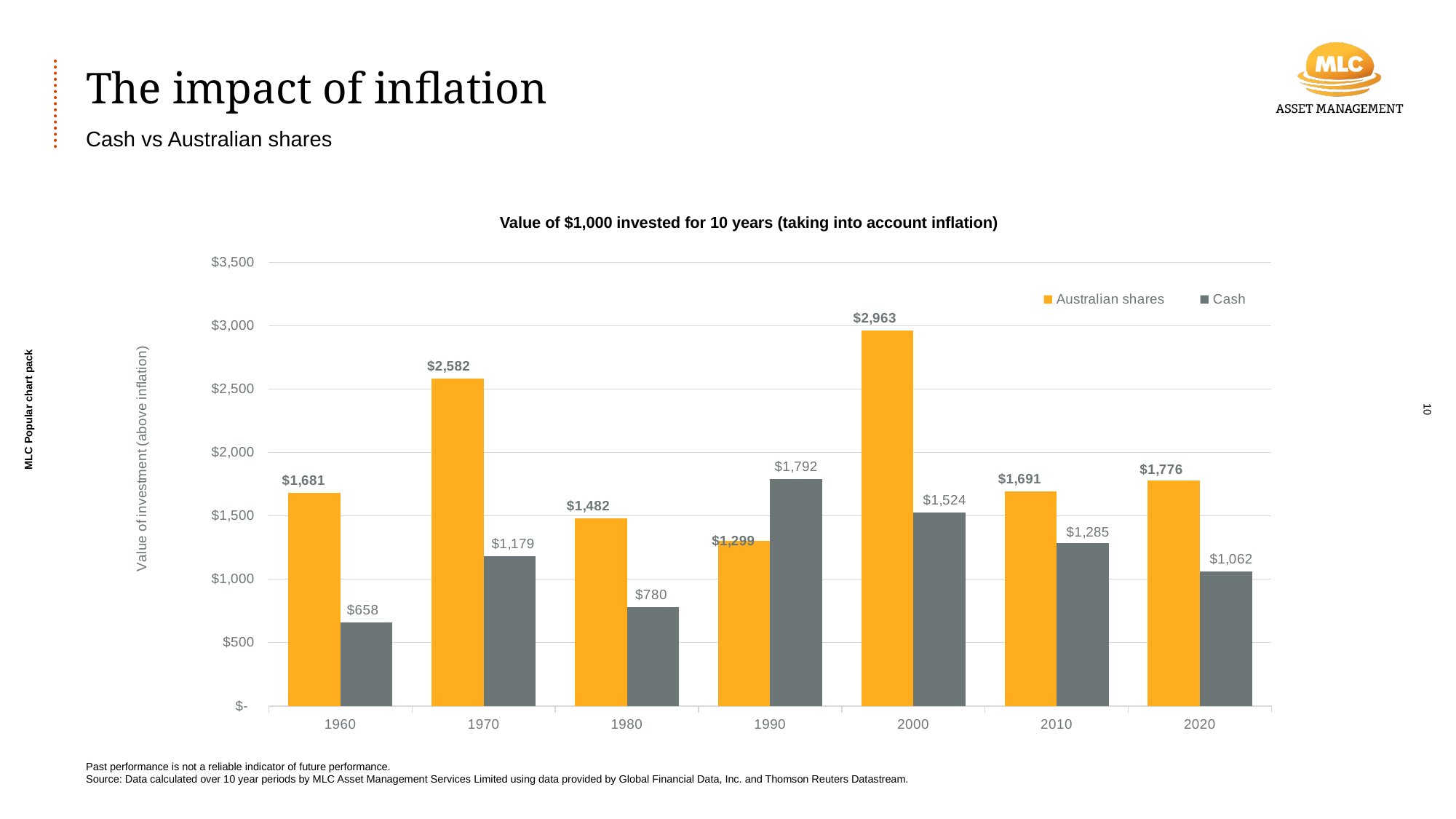
Is the value for Cash in 1980 greater or less than $1,000? less What is the difference between Australian shares and Cash in 1970? $1,403 How many decades are shown on the x axis? 7 Which decade has the highest value for Australian shares? 2000 Which decade has the lowest value for Cash? 1960 What kind of chart is shown? bar chart What is the value for Australian shares in 2000? $2,963 In 1990, which is larger: Australian shares or Cash? Cash What is the value for Cash in 1990? $1,792 How many series does the legend list? 2 What is the title of the chart? Value of $1,000 invested for 10 years (taking into account inflation) What is the value for Cash in 1960? $658